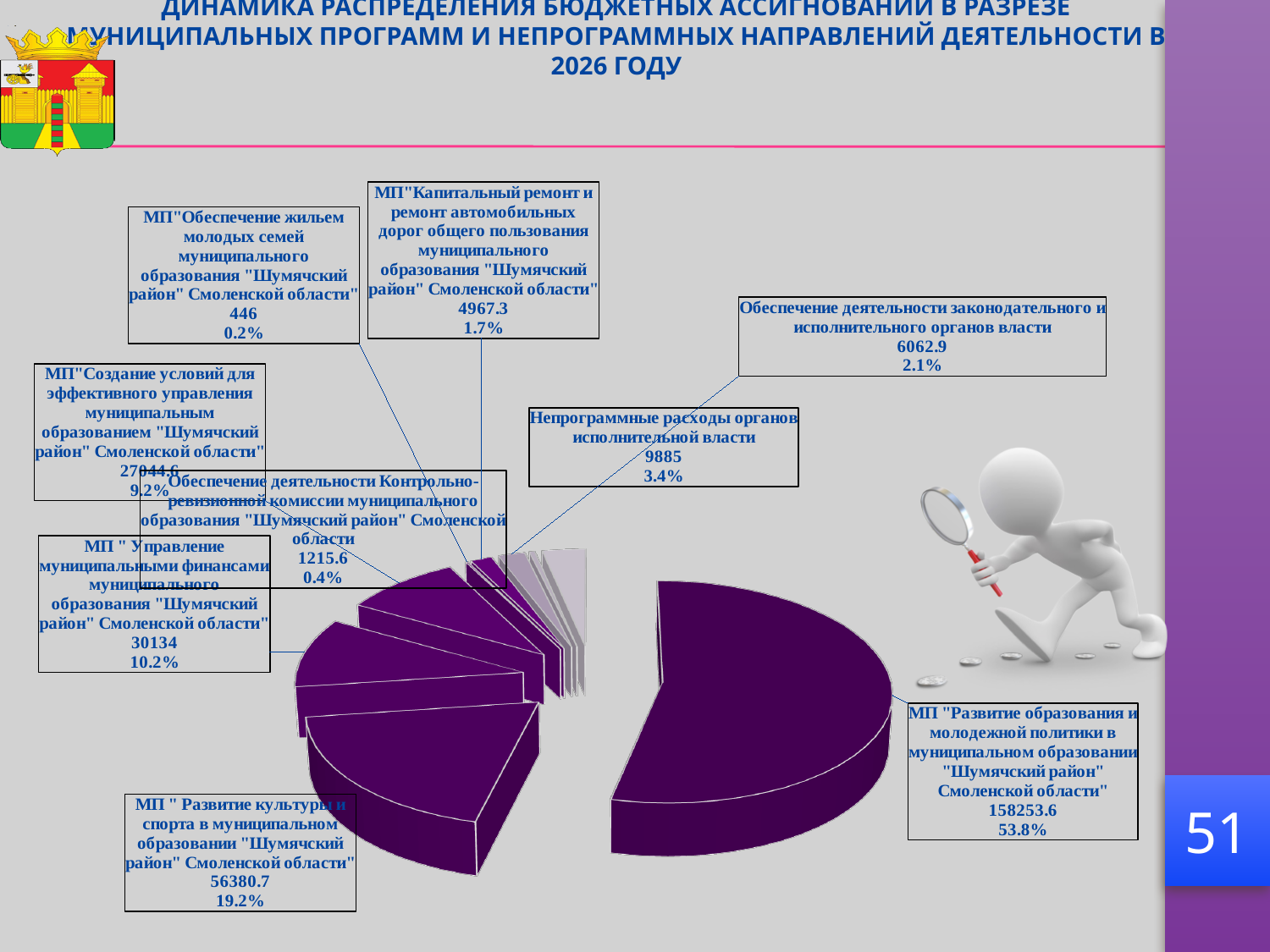
What share of the pie does МП "Развитие культуры и спорта" have? 19.2% Which is larger: the value for МП "Капитальный ремонт и ремонт автомобильных дорог" or for Обеспечение деятельности законодательного и исполнительного органов власти? Обеспечение деятельности законодательного и исполнительного органов власти What share of the pie does МП "Создание условий для эффективного управления" have? 9.2% Which category has the largest share of the pie? МП "Развитие образования и молодежной политики в муниципальном образовании "Шумячский район" Смоленской области" What is the difference between the values for МП "Управление муниципальными финансами" (30134) and Непрограммные расходы органов исполнительной власти (9885)? 20249 What is the value shown for МП "Управление муниципальными финансами"? 30134 What is the value shown for МП "Развитие образования и молодежной политики"? 158253.6 Which category has the smallest share of the pie? МП "Обеспечение жильем молодых семей муниципального образования "Шумячский район" Смоленской области" What percentage is shown for Обеспечение деятельности Контрольно-ревизионной комиссии? 0.4% What kind of chart is shown on the slide? pie chart How many categories (slices) are labelled on the pie chart? 9 What is the value shown for Непрограммные расходы органов исполнительной власти? 9885